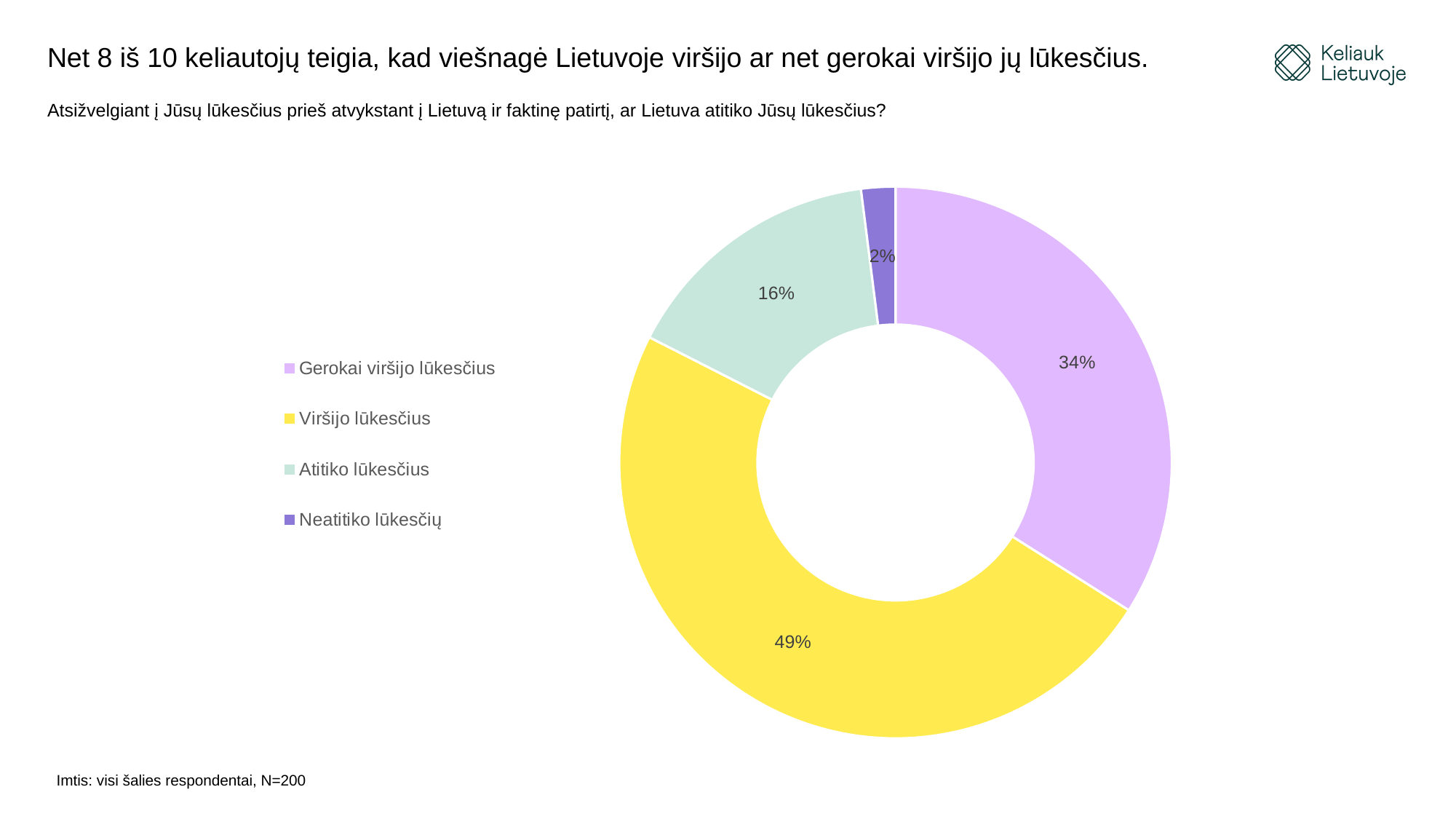
What is the combined share of "Gerokai viršijo lūkesčius" and "Viršijo lūkesčius"? 83% Which category has the largest share of the pie? Viršijo lūkesčius What share of respondents answered "Neatitiko lūkesčių"? 2% What colour is the slice for "Atitiko lūkesčius"? Light green Which is larger: the share for "Atitiko lūkesčius" or the share for "Neatitiko lūkesčių"? Atitiko lūkesčius What share of respondents answered "Gerokai viršijo lūkesčius"? 34% Which category has the smallest share of the pie? Neatitiko lūkesčių What kind of chart is shown on the slide? Pie chart (doughnut) What share of respondents answered "Atitiko lūkesčius"? 16% How many categories does the chart show? 4 What share of respondents answered "Viršijo lūkesčius"? 49% What is the difference in percentage points between "Viršijo lūkesčius" and "Gerokai viršijo lūkesčius"? 15 percentage points